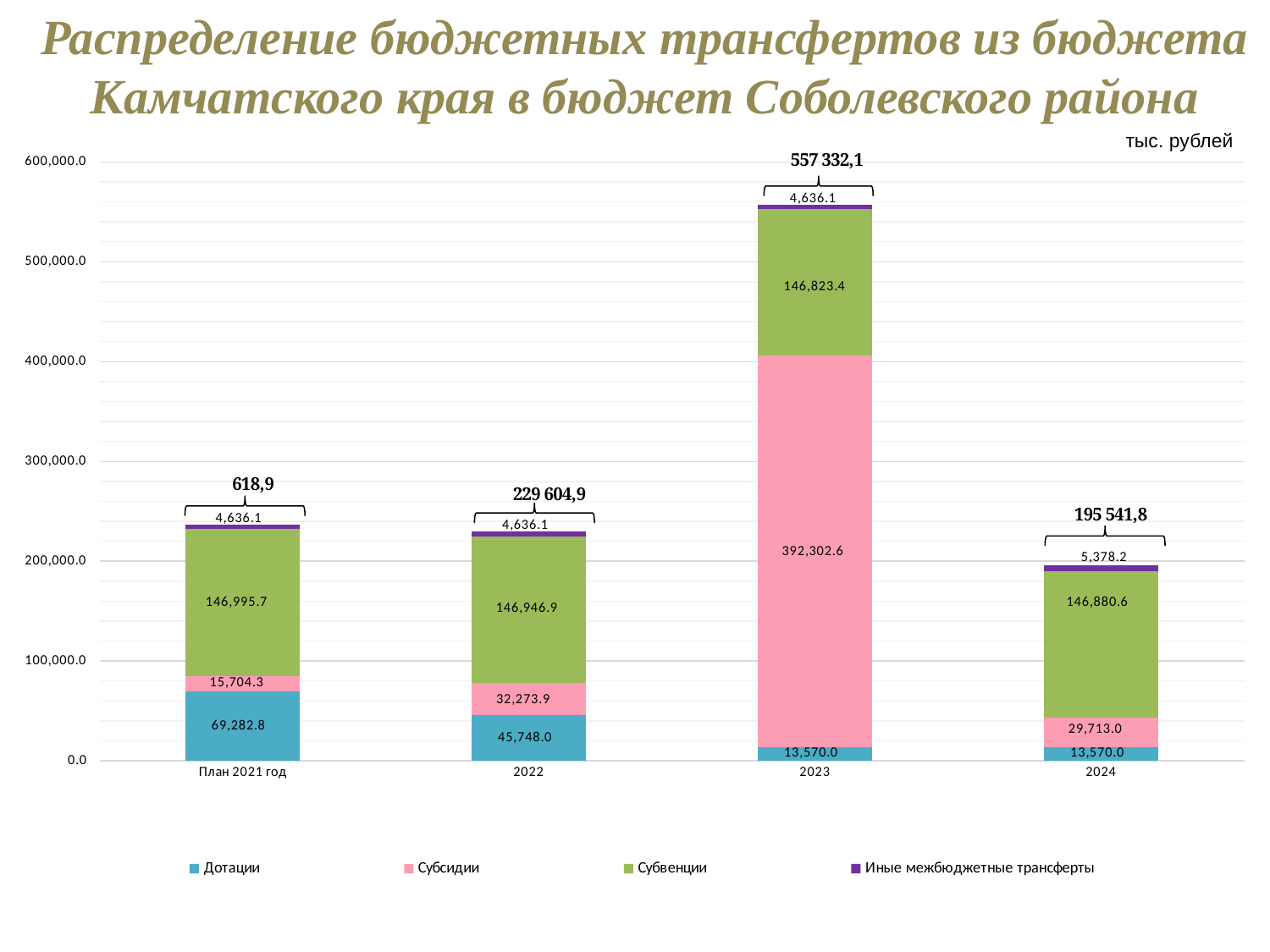
What is the value of Субсидии for 2023? 392,302.6 What is the value of Иные межбюджетные трансферты for 2024? 5,378.2 Which is larger, the Дотации value for План 2021 год or for 2022? План 2021 год Which year has the lowest total stacked bar? 2024 What kind of chart is shown on the slide? Stacked bar chart How many years (categories) are shown on the x axis? 4 What is the total of the stacked bar for 2022? 229 604,9 Does the Дотации value rise or fall from План 2021 год to 2022? Fall What is the difference between the Субсидии value for 2022 and for План 2021 год? 16,569.6 How many series does the legend list? 4 What is the value of Дотации for План 2021 год? 69,282.8 Which year has the highest total stacked bar? 2023